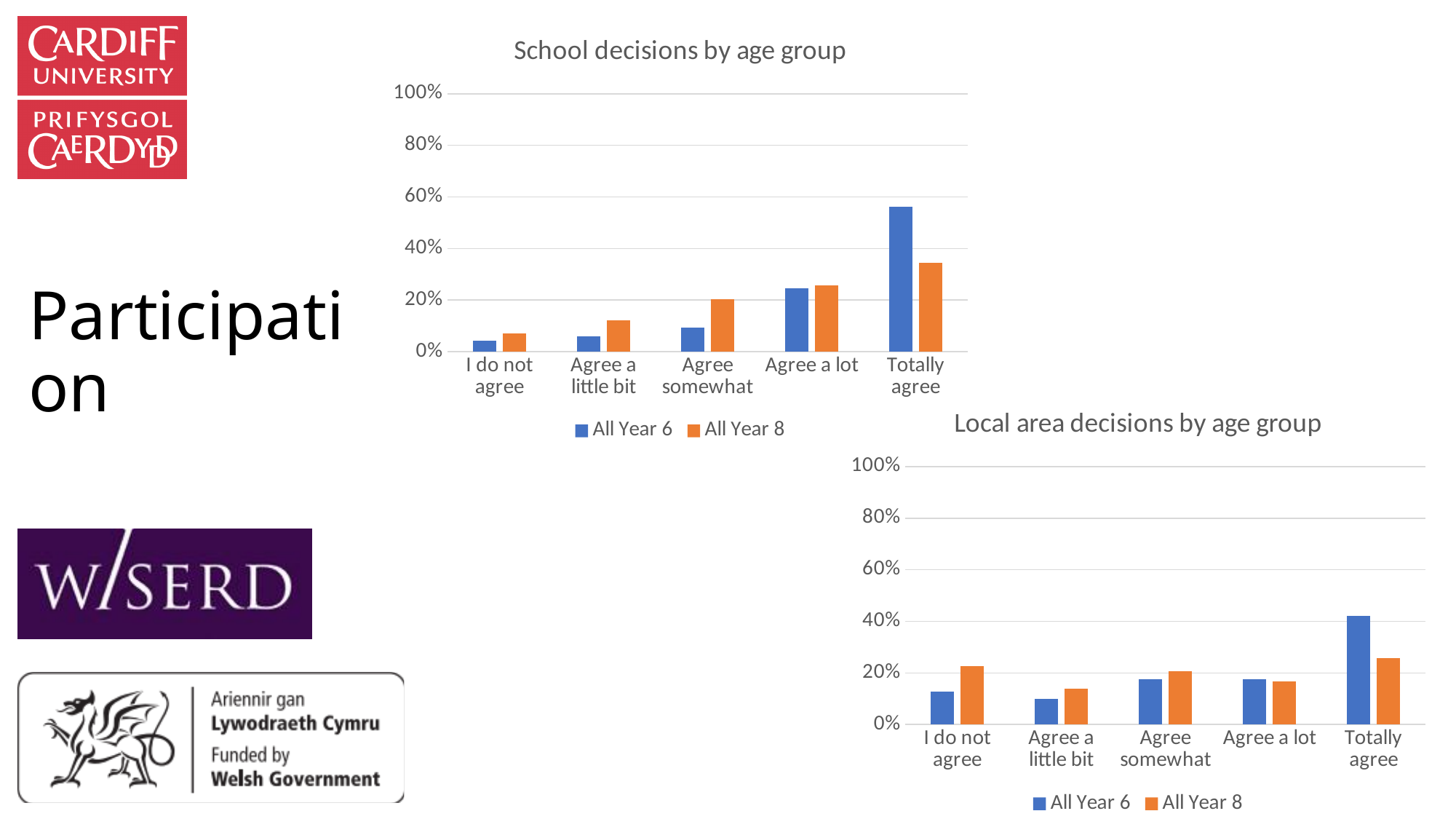
In the 'School decisions by age group' chart, is the All Year 8 value for 'Agree somewhat' greater or less than 40%? less What are the two legend entries in the 'School decisions by age group' chart? All Year 6 and All Year 8 In the 'School decisions by age group' chart, which is larger for 'Totally agree': All Year 6 or All Year 8? All Year 6 In the 'Local area decisions by age group' chart, which category has the highest value for All Year 6? Totally agree How many series does the legend of the 'Local area decisions by age group' chart list? 2 In the 'School decisions by age group' chart, which category has the highest value for All Year 6? Totally agree In the 'Local area decisions by age group' chart, is the All Year 6 value for 'Totally agree' greater or less than 30%? greater In the 'School decisions by age group' chart, is the All Year 6 value for 'Totally agree' greater or less than 40%? greater How many response categories are shown on the x axis of the 'School decisions by age group' chart? 5 In the 'Local area decisions by age group' chart, which is larger for 'I do not agree': All Year 6 or All Year 8? All Year 8 What kind of chart is the 'School decisions by age group' chart? bar chart